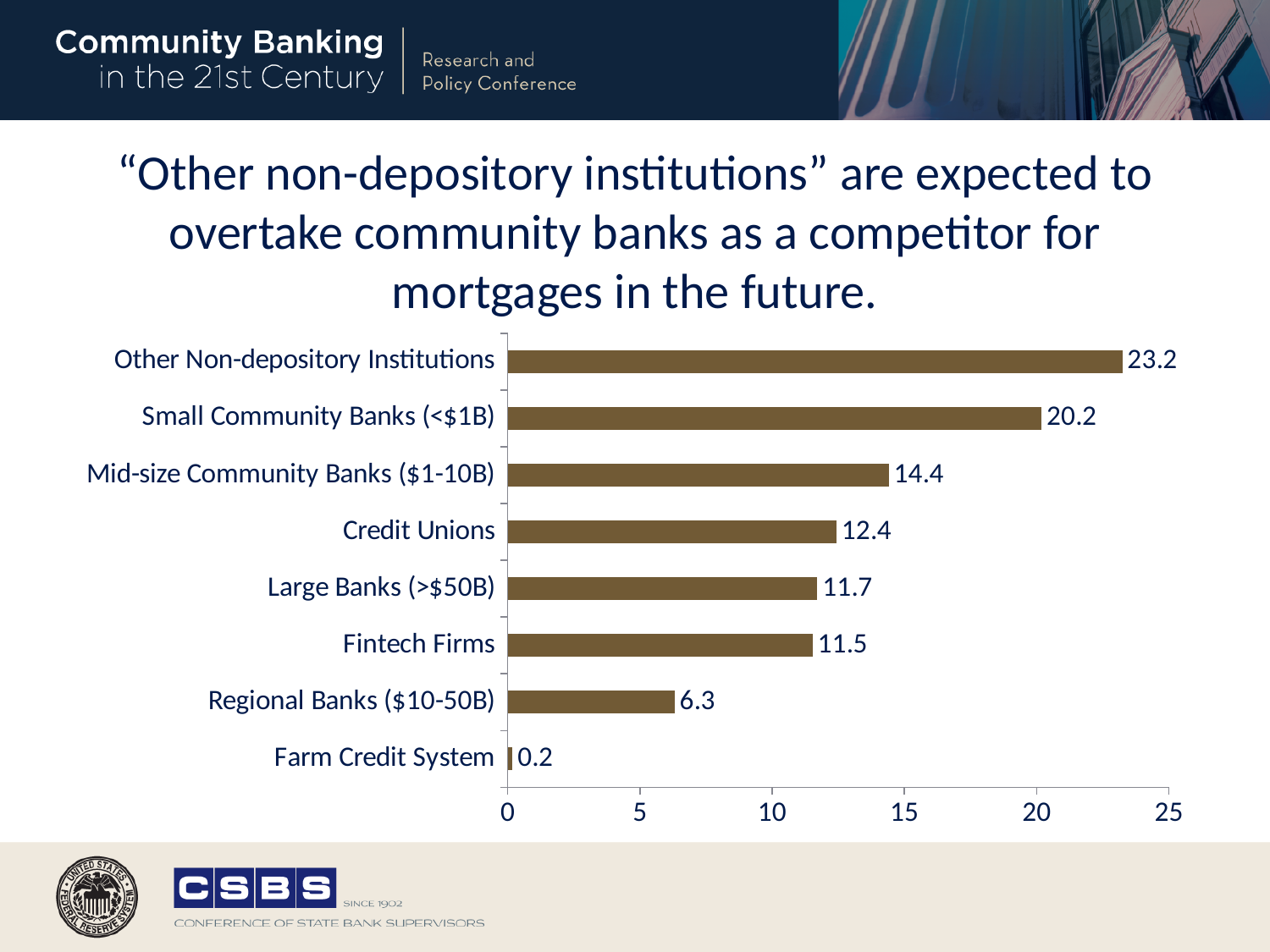
What is the maximum value shown on the horizontal axis? 25 What is the difference between the values for Small Community Banks (<$1B) and Mid-size Community Banks ($1-10B)? 5.8 What is the value for Regional Banks ($10-50B)? 6.3 What is the value for Credit Unions? 12.4 Which category has the lowest value? Farm Credit System Which is larger, the value for Large Banks (>$50B) or the value for Fintech Firms? Large Banks (>$50B) What is the value for Other Non-depository Institutions? 23.2 How many categories are shown in the chart? 8 What is the difference between the values for Other Non-depository Institutions and Small Community Banks (<$1B)? 3.0 What kind of chart is shown on the slide? bar chart Which category has the highest value? Other Non-depository Institutions Is the value for Mid-size Community Banks ($1-10B) greater or less than 15? less